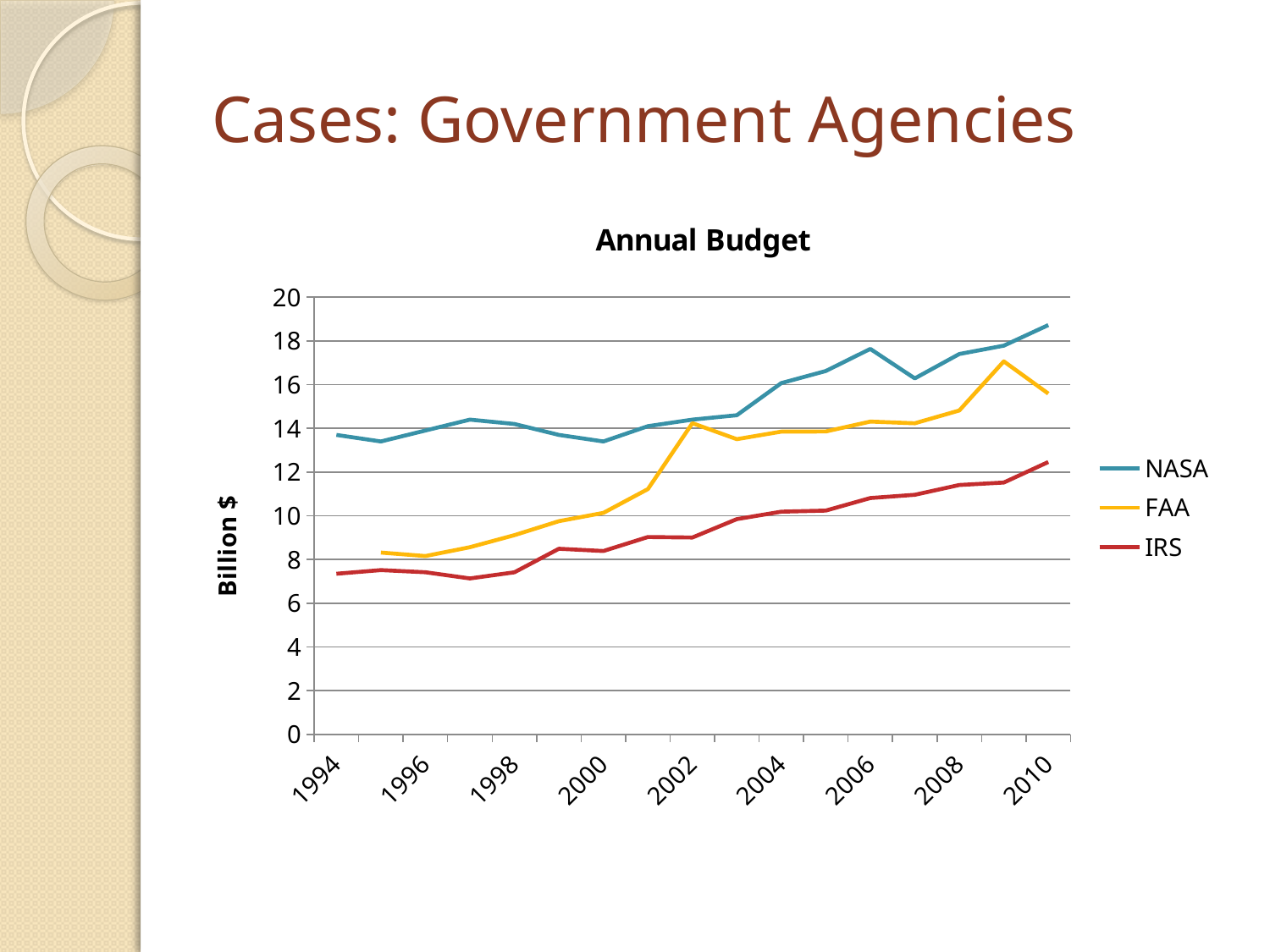
In 2006, which is larger, the FAA value or the IRS value? FAA Is the value for NASA in 2010 greater or less than 18? greater What kind of chart is shown on the slide? line chart Is the value for FAA in 2002 greater or less than 12? greater Is the value for IRS in 1994 greater or less than 8? less How many year labels are shown on the x axis? 9 What is the label on the vertical axis? Billion $ Which series has the highest value in 2010? NASA Do the IRS values generally rise or fall from 1994 to 2010? rise Which series has the lowest value in 1994? IRS How many series does the legend list? 3 What is the title of the chart? Annual Budget